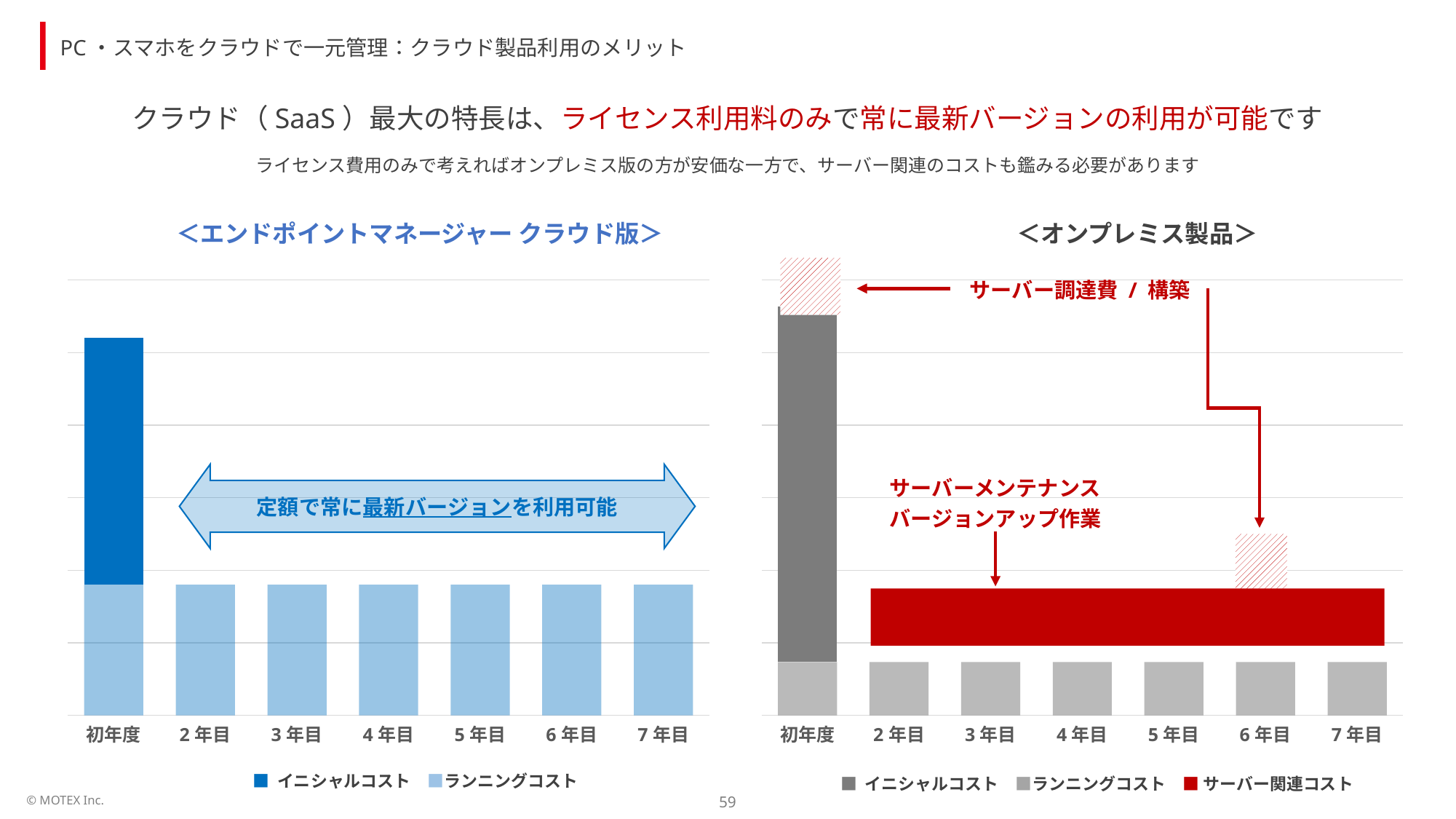
In the right chart (＜オンプレミス製品＞), how many year categories are shown on the x axis? 7 In the left chart (＜エンドポイントマネージャー クラウド版＞), how many year categories are shown on the x axis? 7 In the left chart (＜エンドポイントマネージャー クラウド版＞), which year has the highest total bar? 初年度 In the right chart (＜オンプレミス製品＞), which year has the highest total bar? 初年度 In the left chart (＜エンドポイントマネージャー クラウド版＞), do the bars from 2年目 to 7年目 rise, fall, or stay flat? stay flat What are the three legend entries of the right chart (＜オンプレミス製品＞)? イニシャルコスト, ランニングコスト, サーバー関連コスト How many series does the legend of the left chart (＜エンドポイントマネージャー クラウド版＞) list? 2 What kind of chart is the left chart titled ＜エンドポイントマネージャー クラウド版＞? bar chart How many series does the legend of the right chart (＜オンプレミス製品＞) list? 3 In the left chart (＜エンドポイントマネージャー クラウド版＞), is the total bar for 初年度 larger or smaller than the bar for 2年目? larger What kind of chart is the right chart titled ＜オンプレミス製品＞? bar chart